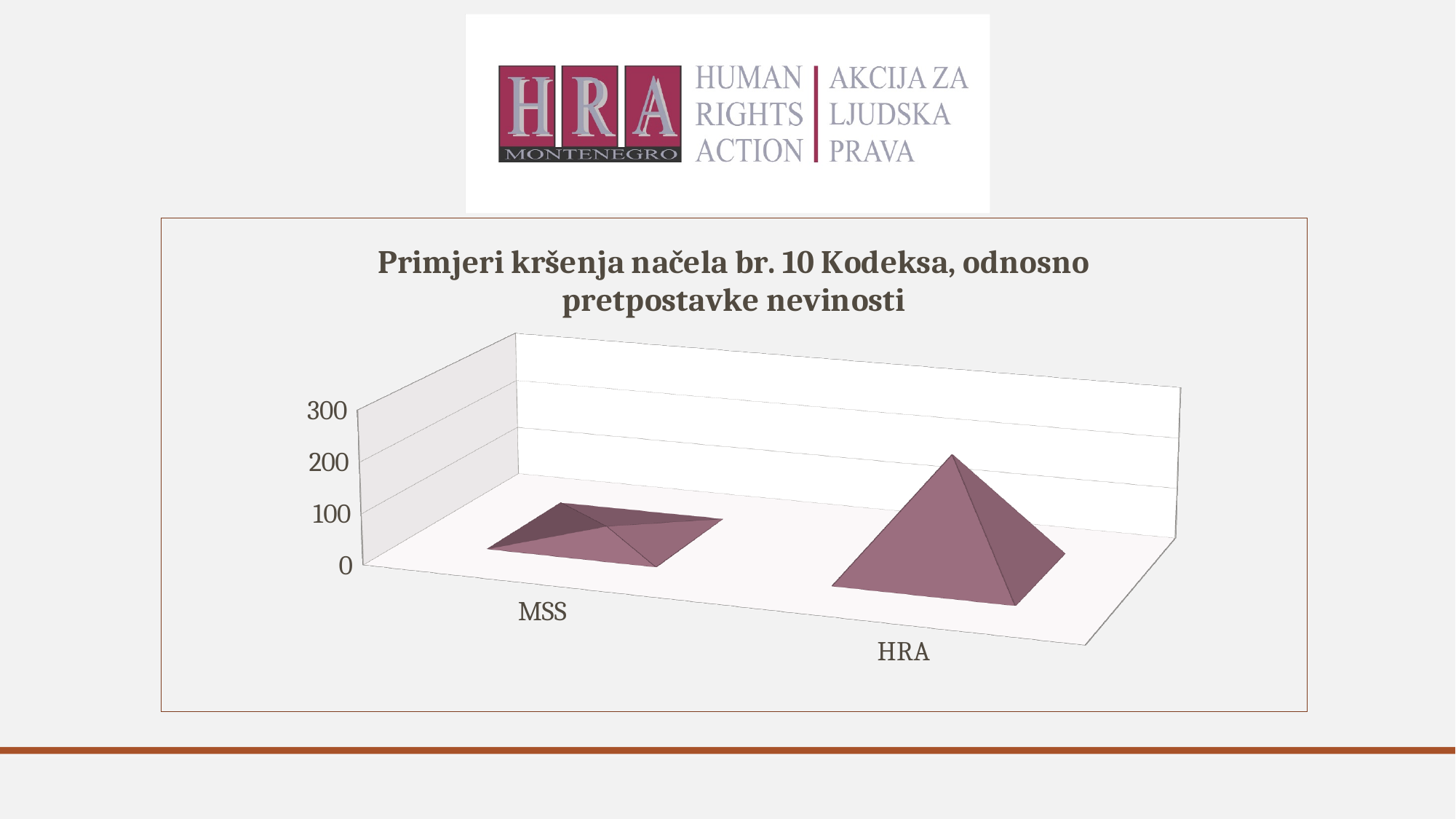
Which is larger, the value for MSS or the value for HRA? HRA Which category has the highest value in the chart? HRA Is the value for HRA greater or less than 300? less What kind of chart is shown on the slide? bar chart Is the value for MSS greater or less than 100? less Is the value for HRA greater or less than 100? greater What is the title of the chart? Primjeri kršenja načela br. 10 Kodeksa, odnosno pretpostavke nevinosti How many categories are shown on the x axis of the chart? 2 Which category has the lowest value in the chart? MSS What is the highest tick value shown on the vertical axis of the chart? 300